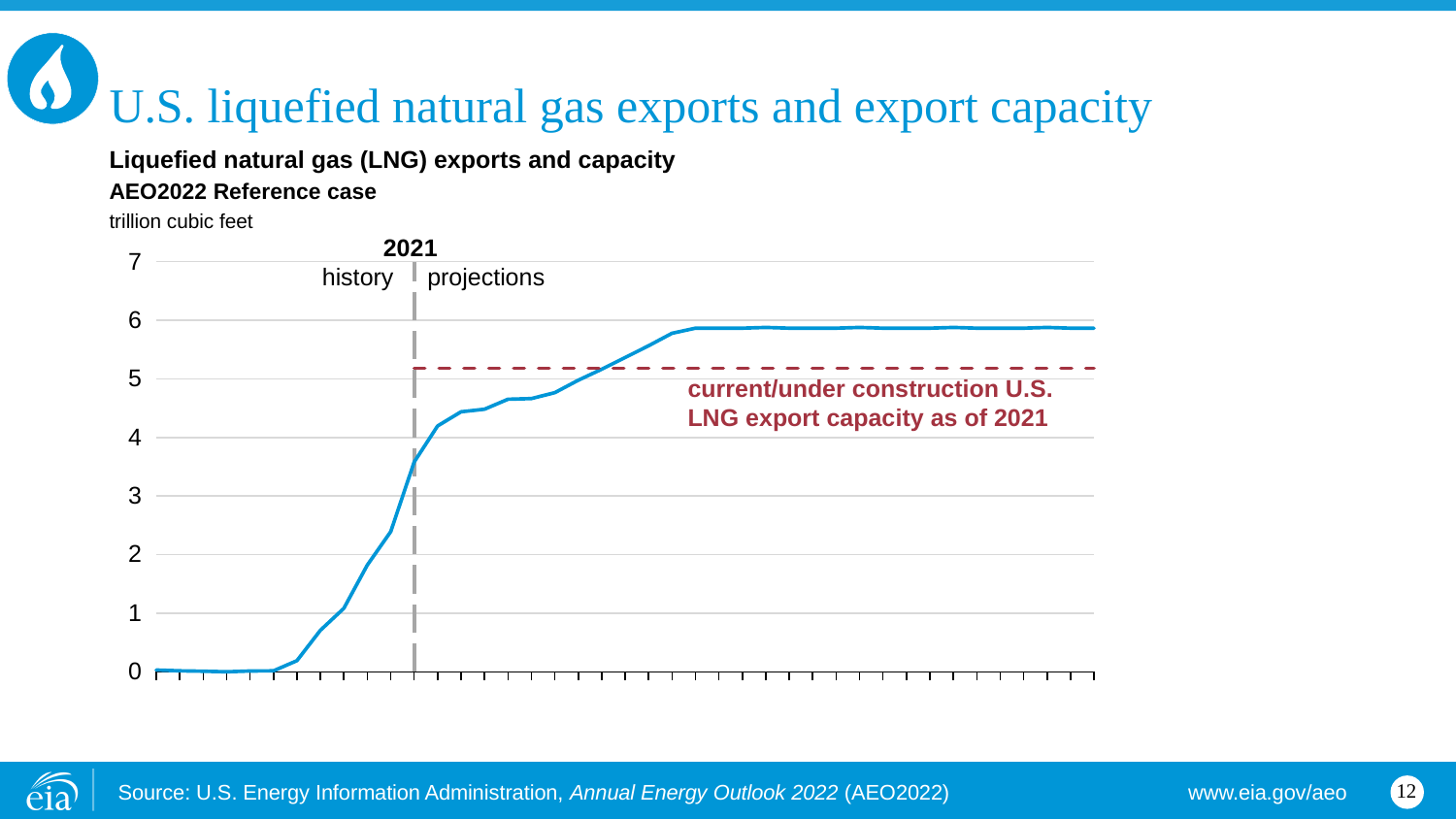
Is the current/under construction U.S. LNG export capacity as of 2021 greater or less than 6? less Is the projected LNG export level at the end of the projection period greater or less than 5? greater In the later projection years, which is larger: projected LNG exports or the current/under construction export capacity as of 2021? projected LNG exports Is the current/under construction U.S. LNG export capacity as of 2021 greater or less than 5? greater What unit is the y axis measured in? trillion cubic feet What kind of chart is shown on the slide? line chart Which year separates history from projections on the chart? 2021 What is the title of the chart? Liquefied natural gas (LNG) exports and capacity Does the LNG exports line rise or fall over the history period? rise What is the highest value shown on the y axis? 7